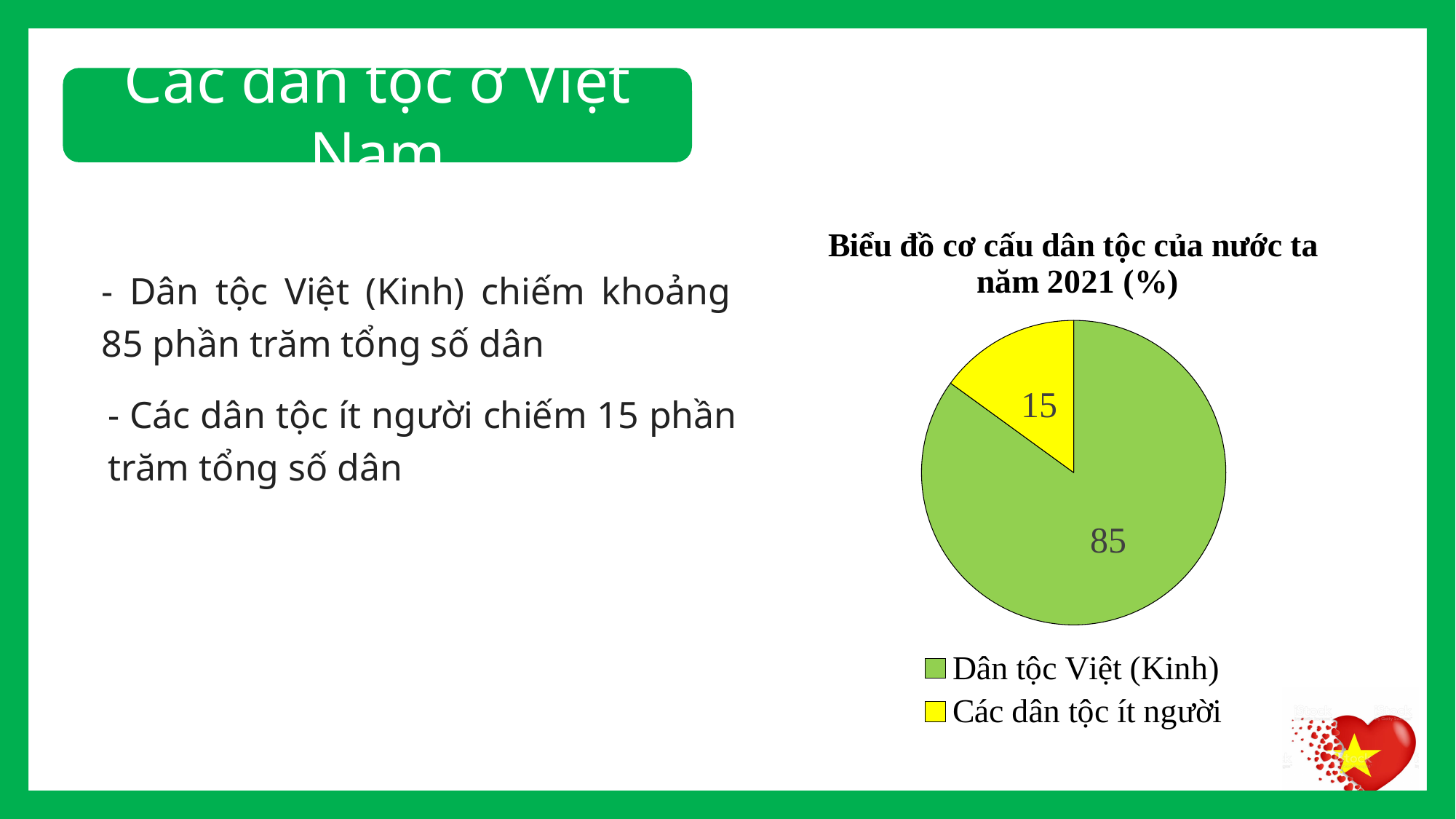
What is the value shown for Dân tộc Việt (Kinh) in the pie chart? 85 How many entries does the legend list? 2 What is the value shown for Các dân tộc ít người in the pie chart? 15 Which is larger: the slice for Dân tộc Việt (Kinh) or the slice for Các dân tộc ít người? Dân tộc Việt (Kinh) What colour is the slice for Các dân tộc ít người? yellow What is the difference between the values for Dân tộc Việt (Kinh) and Các dân tộc ít người? 70 What kind of chart is shown on the slide? pie chart What is the title of the pie chart? Biểu đồ cơ cấu dân tộc của nước ta năm 2021 (%) Which category has the smallest slice of the pie chart? Các dân tộc ít người How many slices does the pie chart have? 2 Which category has the largest slice of the pie chart? Dân tộc Việt (Kinh) What share of the pie does the Dân tộc Việt (Kinh) slice represent? 85%